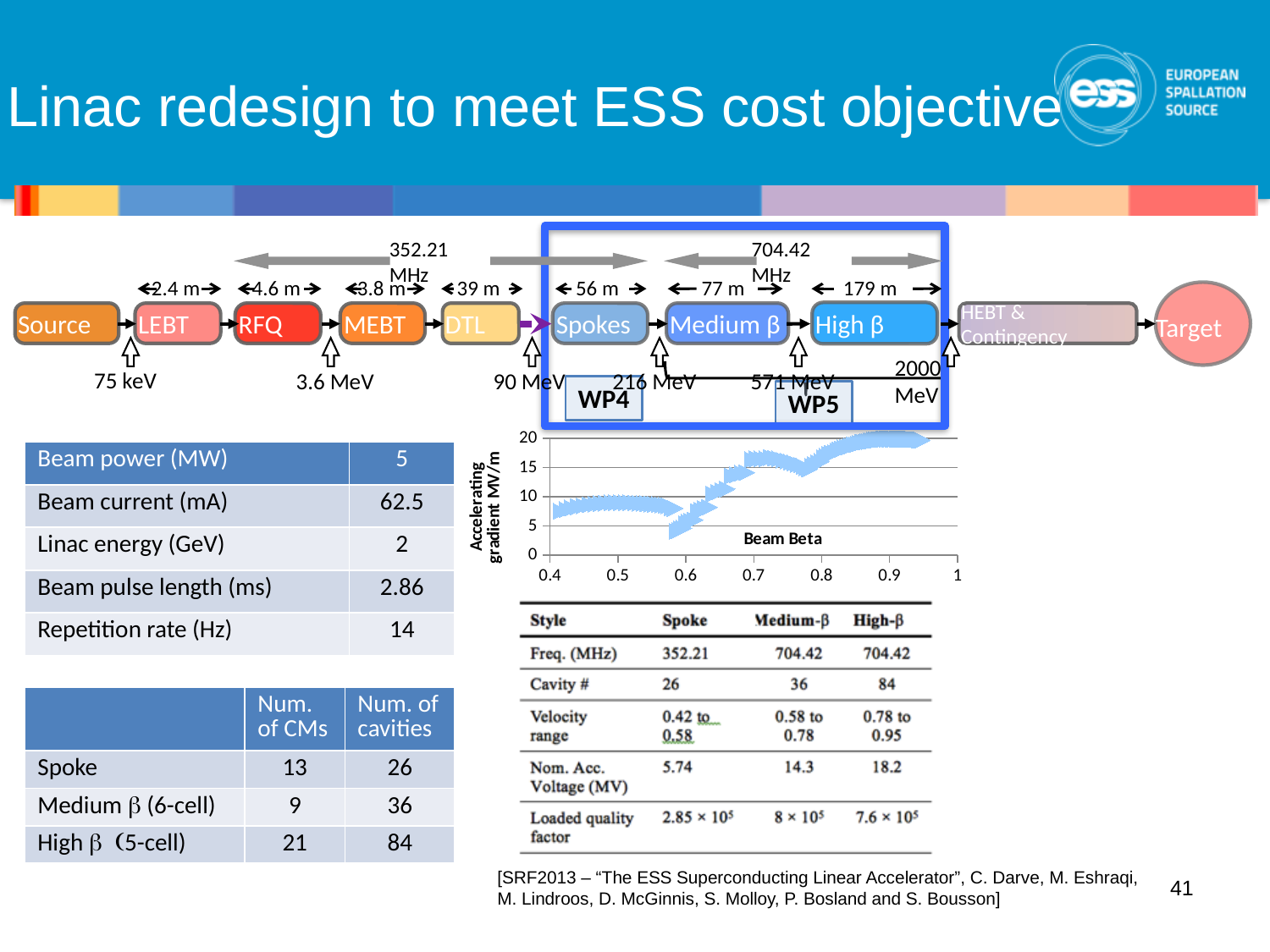
Which has the higher accelerating gradient: beam beta 0.6 or beam beta 0.9? 0.9 Is the accelerating gradient at a beam beta of 0.9 greater or less than 15 MV/m? greater Is the accelerating gradient at a beam beta of 0.5 greater or less than 10 MV/m? less Is the accelerating gradient at a beam beta of 0.95 greater or less than 15 MV/m? greater Which has the higher accelerating gradient: beam beta 0.7 or beam beta 0.5? 0.7 What is the label of the vertical axis of the chart? Accelerating gradient MV/m Overall, does the accelerating gradient rise or fall as beam beta increases from 0.4 to 1? rises Which has the higher accelerating gradient: beam beta 0.9 or beam beta 0.5? 0.9 What is the label of the horizontal axis of the chart? Beam Beta